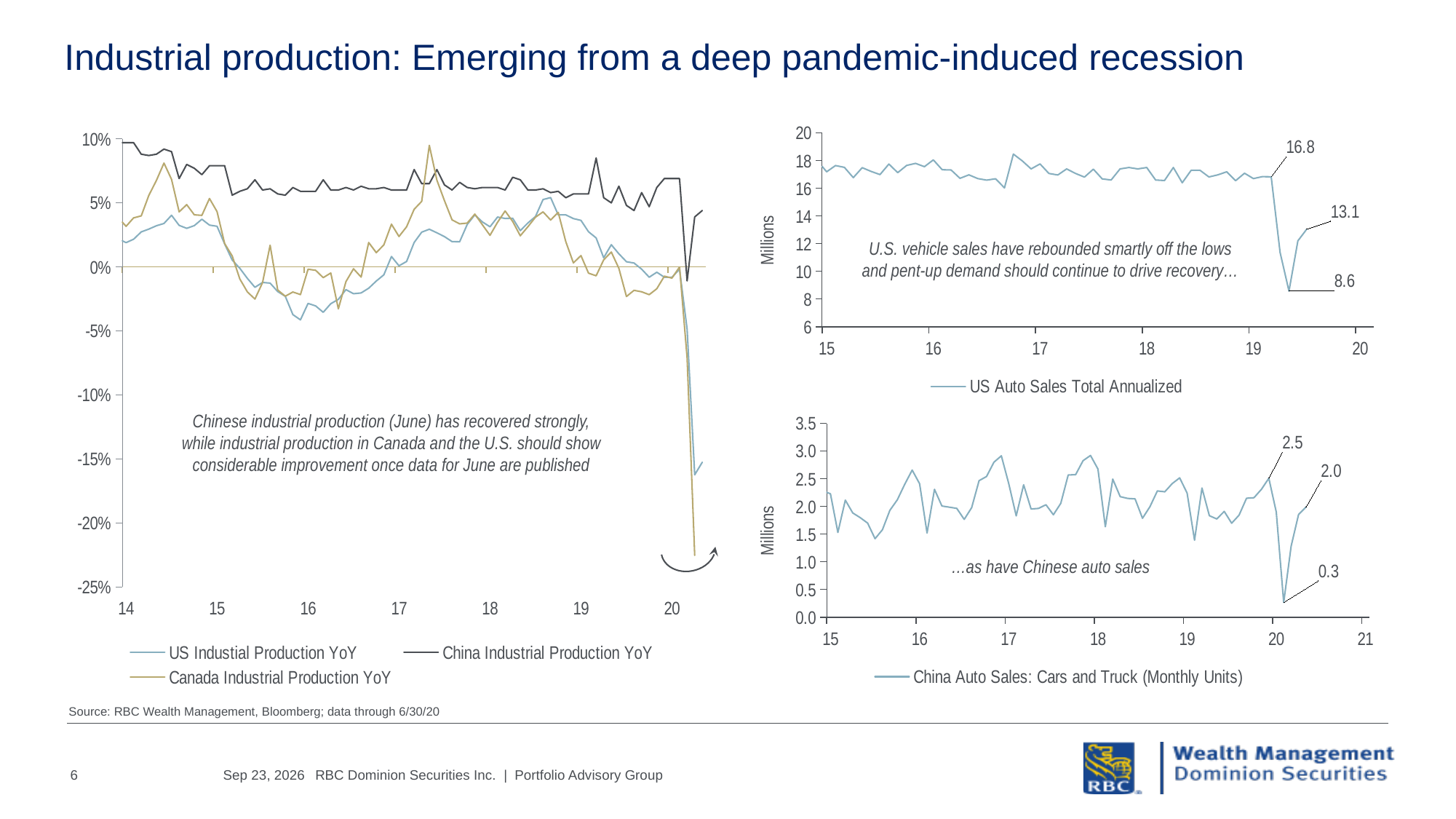
On the bottom-right chart (China Auto Sales), which labeled value is larger, 2.5 or 2.0? 2.5 On the top-right chart (US Auto Sales Total Annualized), what is the difference between the labeled values 13.1 and 8.6? 4.5 On the top-right chart (US Auto Sales Total Annualized), what is the difference between the labeled values 16.8 and 8.6? 8.2 On the bottom-right chart (China Auto Sales), what is the lowest labeled value? 0.3 What is the legend entry of the top-right chart? US Auto Sales Total Annualized What kind of chart is the left chart showing industrial production YoY? line chart On the left chart, is the lowest point of Canada Industrial Production YoY in 2020 greater or less than -20%? less On the bottom-right chart (China Auto Sales), what is the difference between the labeled values 2.5 and 0.3? 2.2 On the left chart (industrial production YoY), how many series does the legend list? 3 On the top-right chart (US Auto Sales Total Annualized), what is the lowest labeled value? 8.6 What is the y-axis label of the bottom-right chart (China Auto Sales)? Millions On the left chart, is China Industrial Production YoY at the start of 2014 greater or less than 5%? greater